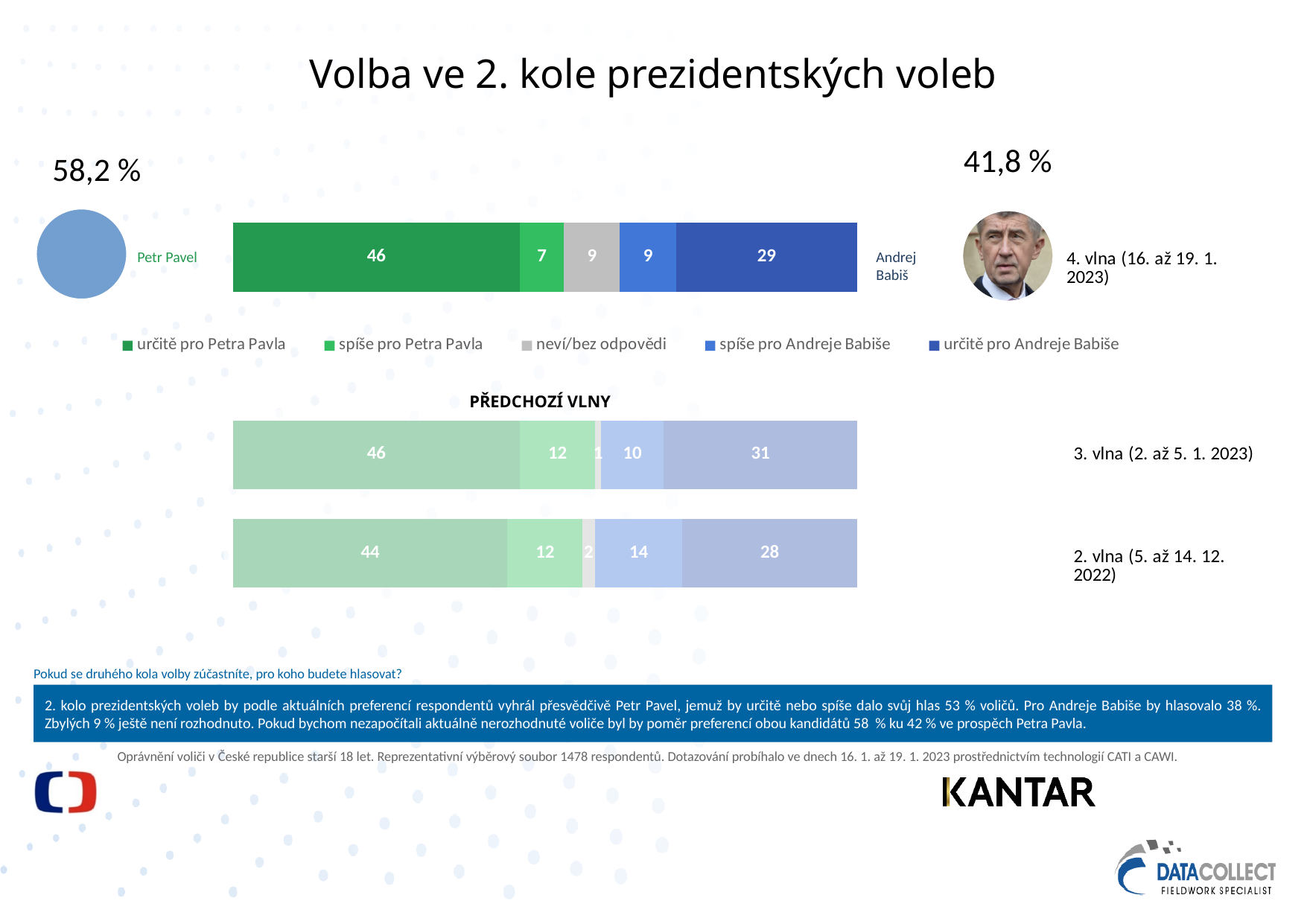
Which is larger in the 3. vlna bar: 'spíše pro Petra Pavla' or 'spíše pro Andreje Babiše'? spíše pro Petra Pavla Which segment is the smallest in the 3. vlna bar? neví/bez odpovědi In the 4. vlna bar, what is the value for 'neví/bez odpovědi'? 9 In the 3. vlna bar, what is the value for 'určitě pro Andreje Babiše'? 31 What is the total of the 2. vlna stacked bar? 100 How many series does the legend list? 5 In the 2. vlna bar, what is the value for 'spíše pro Andreje Babiše'? 14 In the 4. vlna bar, what is the value for 'určitě pro Petra Pavla'? 46 What percentage is shown next to Petr Pavel at the top left of the slide? 58,2 % What is the difference between 'určitě pro Petra Pavla' and 'určitě pro Andreje Babiše' in the 4. vlna bar? 17 What kind of chart is shown on the slide? stacked bar chart Which segment is the largest in the 2. vlna bar? určitě pro Petra Pavla